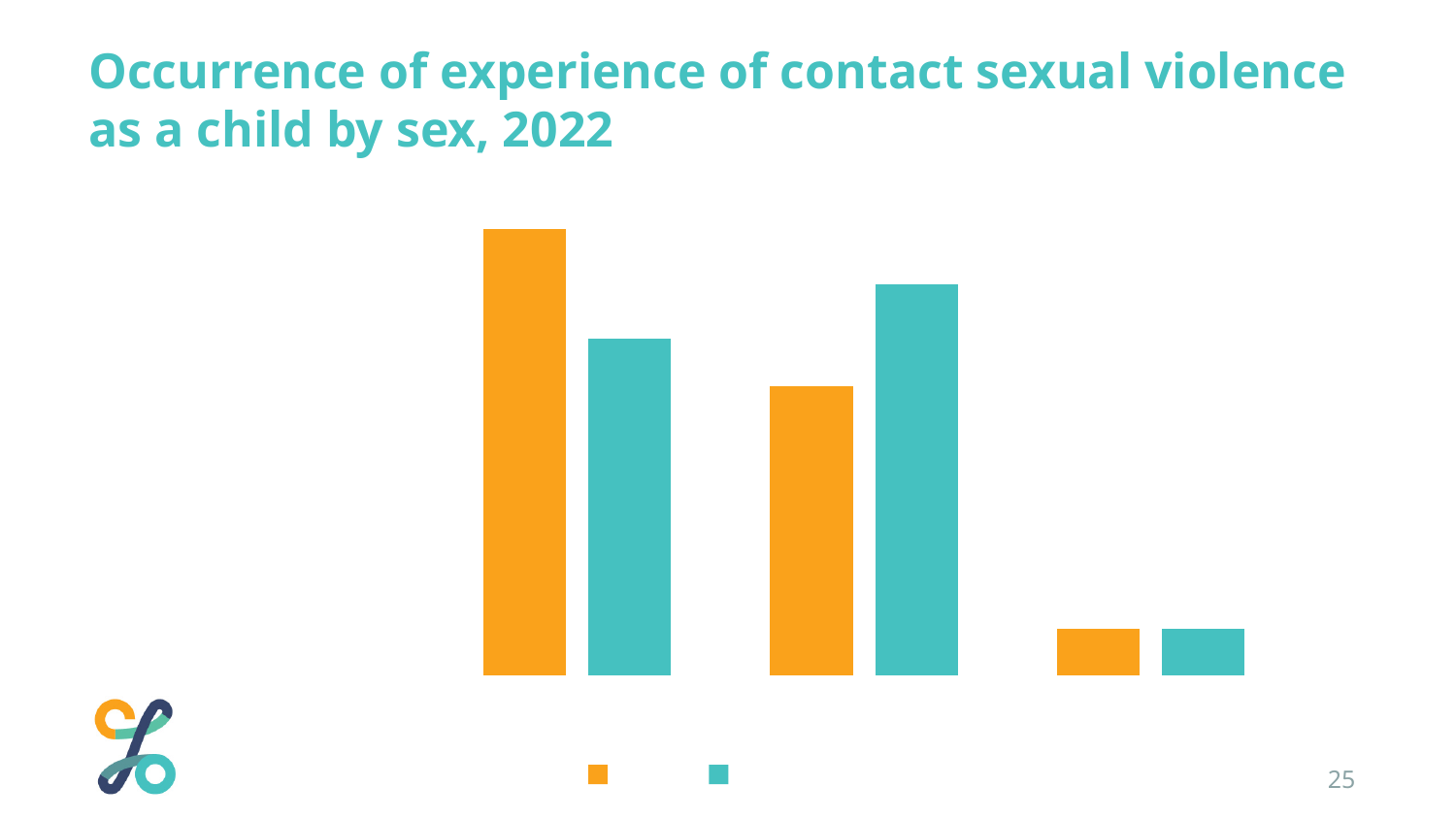
What two colours are used for the bars in the chart? orange and teal How many series does the legend show? 2 In the leftmost group of bars, which bar is taller, the orange one or the teal one? the orange one Which single bar is the tallest in the chart: the orange bar in the left group, the teal bar in the middle group, or the orange bar in the right group? the orange bar in the left group What is the title of the chart? Occurrence of experience of contact sexual violence as a child by sex, 2022 In the middle group of bars, which bar is taller, the orange one or the teal one? the teal one Which group of bars has the shortest bars overall: the left, middle or right group? the right group How many groups of bars are plotted in the chart? 3 How many bars are plotted in total in the chart? 6 What kind of chart is shown on the slide? bar chart